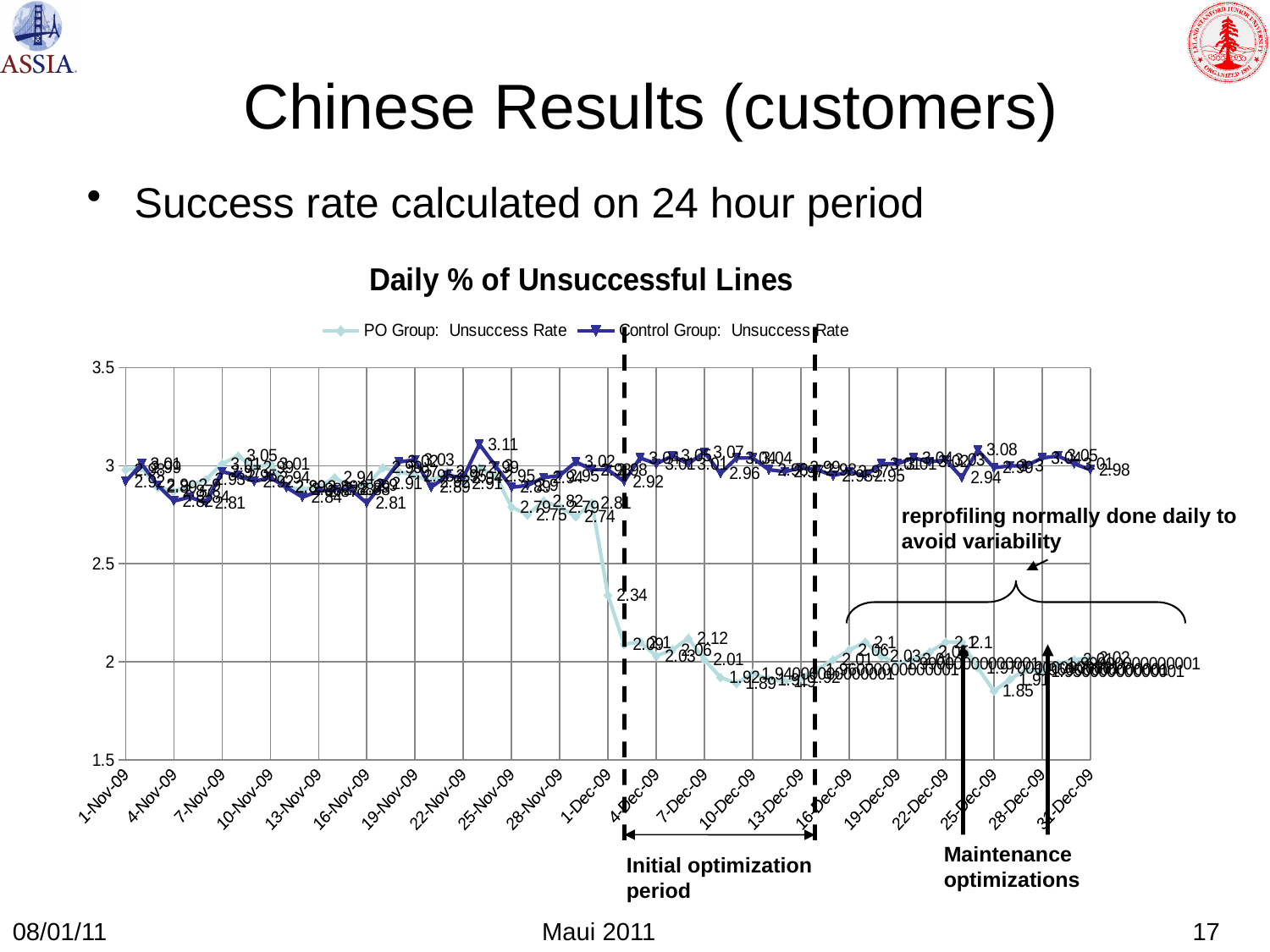
What is the title of the chart? Daily % of Unsuccessful Lines Is the PO Group: Unsuccess Rate value around 10-Dec-09 greater or less than 2.5? less Around 10-Dec-09, which series has the higher value, PO Group or Control Group? Control Group What is the highest value labeled for the Control Group: Unsuccess Rate series? 3.11 What kind of chart is shown on the slide? line chart Is the Control Group: Unsuccess Rate value around 10-Dec-09 greater or less than 2.5? greater What are the two series named in the chart legend? PO Group: Unsuccess Rate and Control Group: Unsuccess Rate Does the PO Group: Unsuccess Rate series rise or fall between 1-Dec-09 and 10-Dec-09? fall What is the lowest value labeled for the PO Group: Unsuccess Rate series? 1.85 How many series does the chart legend list? 2 What is the last value labeled for the Control Group: Unsuccess Rate series at the right end of the chart? 2.98 What are the minimum and maximum values shown on the y axis? 1.5 and 3.5